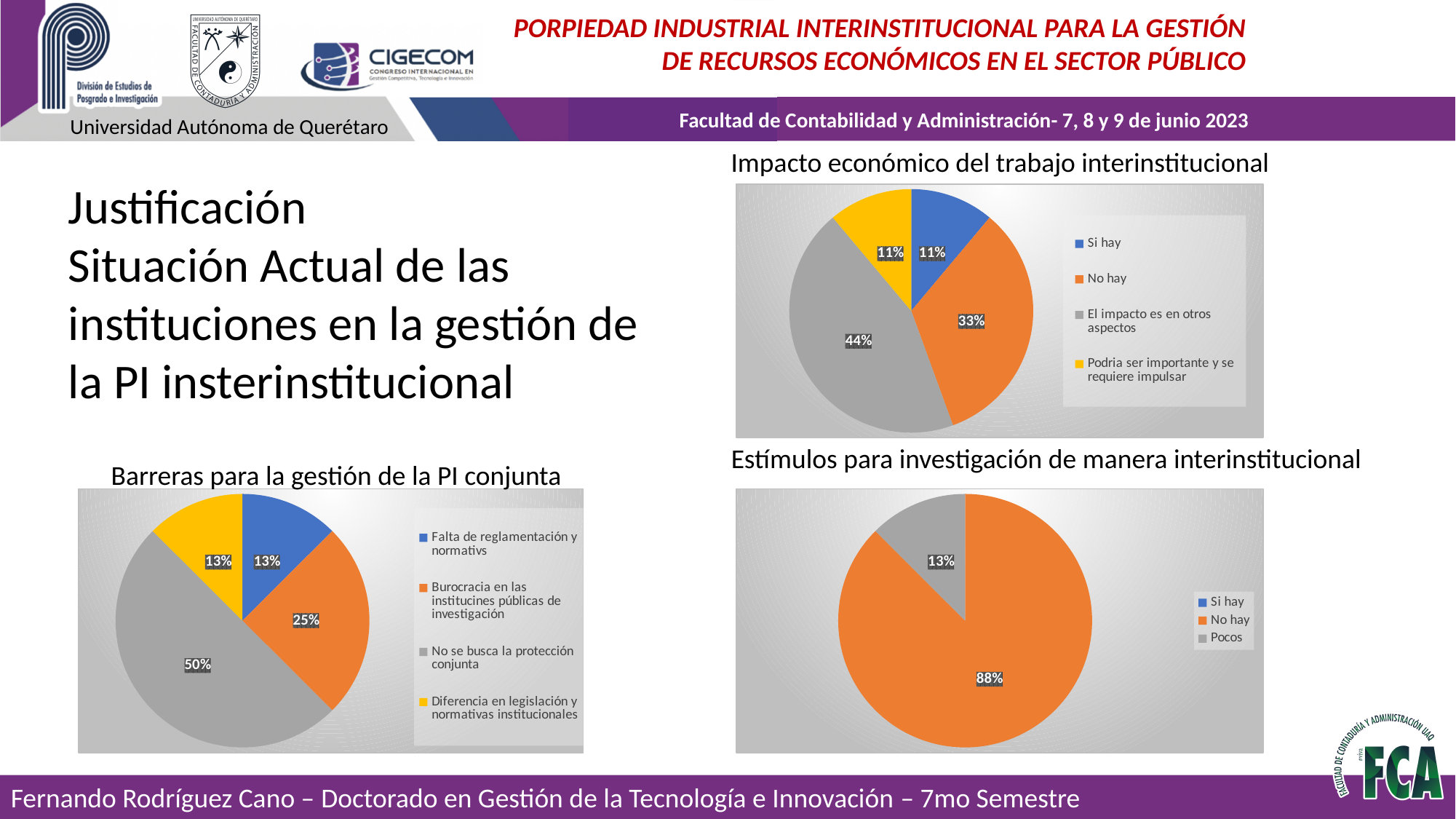
In the 'Barreras para la gestión de la PI conjunta' chart, what is the difference between the 'No se busca la protección conjunta' slice and the 'Burocracia en las institucines públicas de investigación' slice? 25% What type of chart is 'Estímulos para investigación de manera interinstitucional'? Pie chart In the 'Impacto económico del trabajo interinstitucional' chart, how many categories does the legend list? 4 In the 'Estímulos para investigación de manera interinstitucional' chart, what share is labelled for 'Pocos'? 13% In the 'Impacto económico del trabajo interinstitucional' chart, what share is labelled for 'El impacto es en otros aspectos'? 44% In the 'Barreras para la gestión de la PI conjunta' chart, which is larger: 'Falta de reglamentación y normativs' or 'Burocracia en las institucines públicas de investigación'? Burocracia en las institucines públicas de investigación In the 'Impacto económico del trabajo interinstitucional' chart, what share is labelled for 'No hay'? 33% In the 'Barreras para la gestión de la PI conjunta' chart, what share is labelled for 'Burocracia en las institucines públicas de investigación'? 25% In the 'Estímulos para investigación de manera interinstitucional' chart, what colour is the 'No hay' slice? Orange In the 'Estímulos para investigación de manera interinstitucional' chart, what share is labelled for 'No hay'? 88% In the 'Barreras para la gestión de la PI conjunta' chart, what share is labelled for 'No se busca la protección conjunta'? 50% In the 'Impacto económico del trabajo interinstitucional' chart, which category has the largest slice? El impacto es en otros aspectos